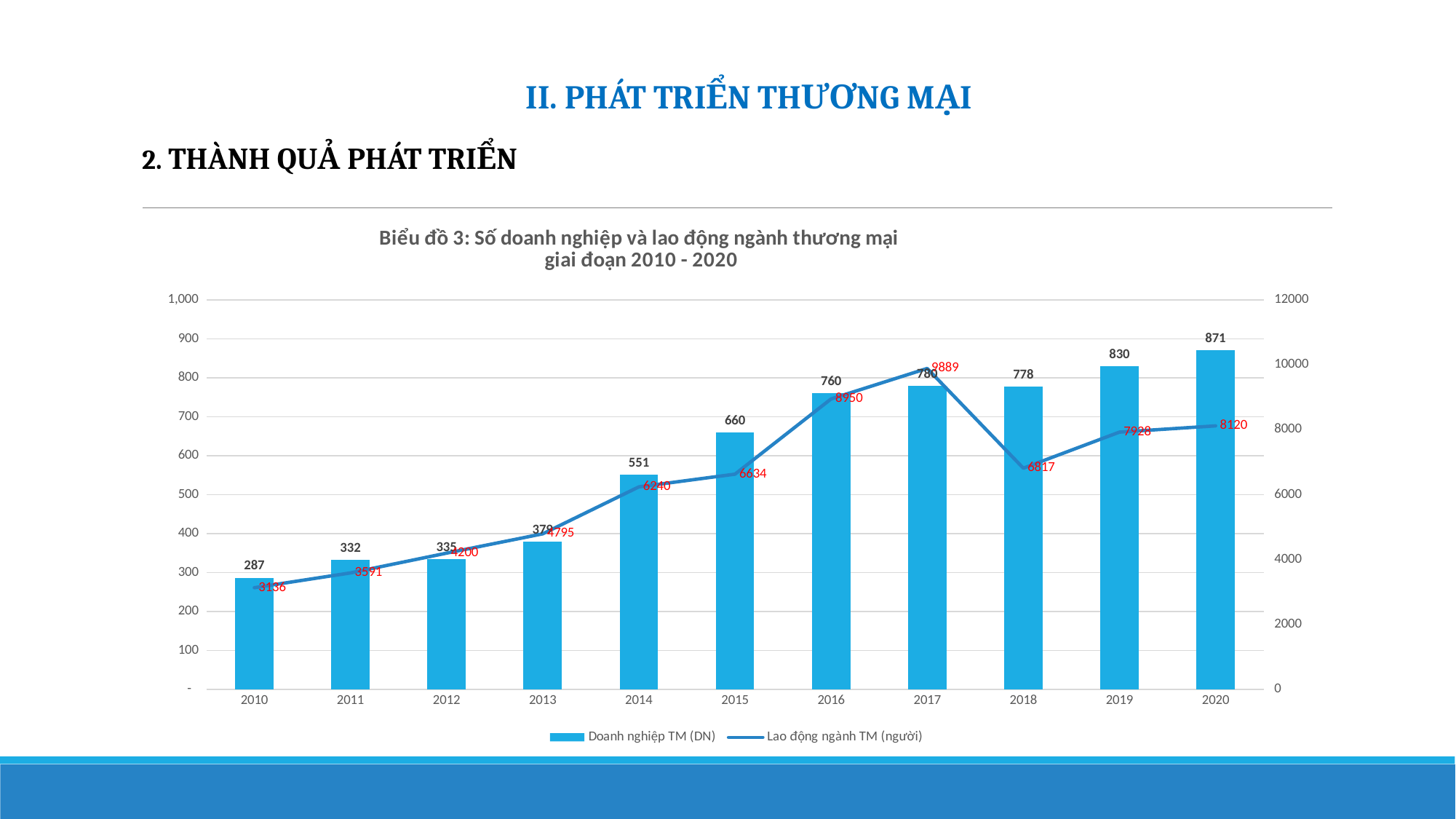
What is the value of Lao động ngành TM (người) for 2018? 6817 How many series does the legend list? 2 Which year has the lowest value for Doanh nghiệp TM (DN)? 2010 Which year has the highest value for Lao động ngành TM (người)? 2017 What is the difference between the Doanh nghiệp TM (DN) values for 2020 and 2019? 41 What is the value of Doanh nghiệp TM (DN) for 2014? 551 What is the value of Doanh nghiệp TM (DN) for 2020? 871 What is the value of Lao động ngành TM (người) for 2017? 9889 Which year has the highest value for Doanh nghiệp TM (DN)? 2020 Which is larger, the Lao động ngành TM (người) value for 2016 or for 2019? 2016 What is the title of the chart? Biểu đồ 3: Số doanh nghiệp và lao động ngành thương mại giai đoạn 2010 - 2020 How many years are shown on the x axis? 11